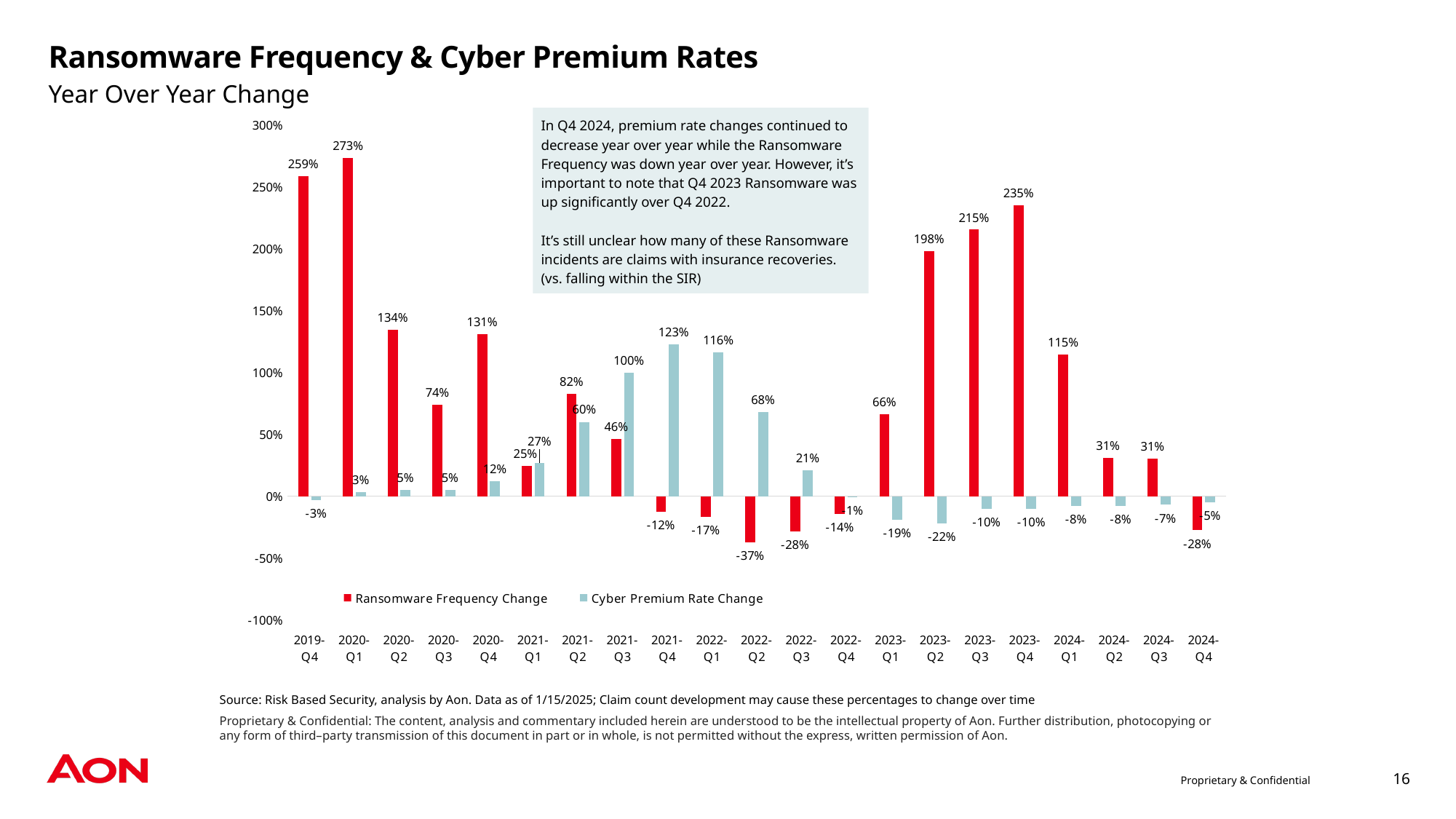
What is the Cyber Premium Rate Change for 2021-Q4? 123% Which quarter has the highest Ransomware Frequency Change? 2020-Q1 Which quarter has the lowest Cyber Premium Rate Change? 2023-Q2 What is the Ransomware Frequency Change for 2024-Q4? -28% How many quarters are shown on the x axis? 21 What is the difference between the Ransomware Frequency Change for 2023-Q4 and 2024-Q1? 120% What kind of chart is shown on the slide? Bar chart How many series does the legend list? 2 What is the Ransomware Frequency Change for 2020-Q1? 273% Which quarter has the lowest Ransomware Frequency Change? 2022-Q2 Which is larger in 2022-Q1: the Ransomware Frequency Change or the Cyber Premium Rate Change? Cyber Premium Rate Change Does the Cyber Premium Rate Change rise or fall from 2021-Q4 to 2022-Q4? Fall